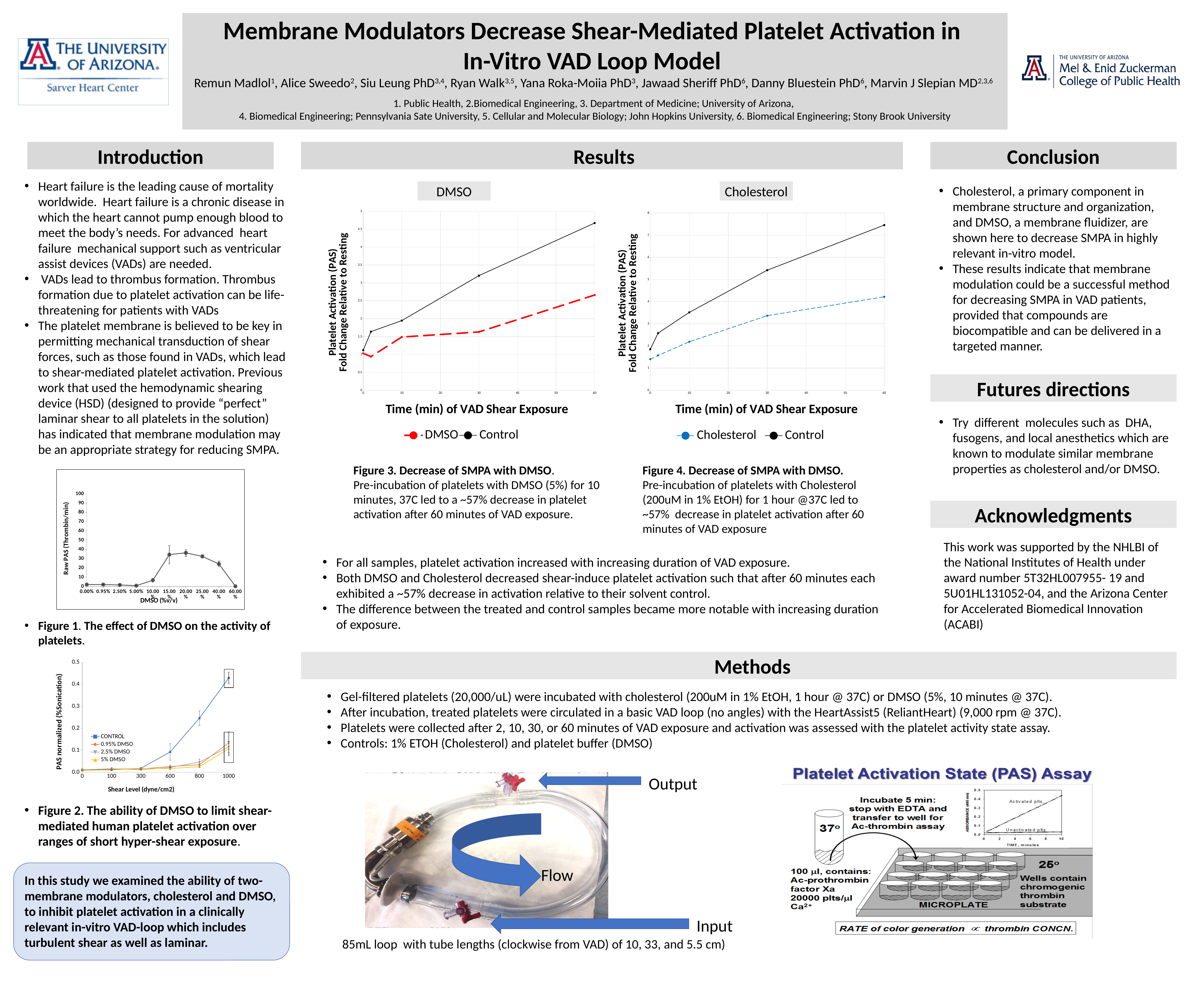
In the DMSO chart, is the DMSO value at 60 minutes greater or less than 3? less What kind of chart is the DMSO chart in the Results section? line chart In the DMSO chart, which series has the larger value at 60 minutes, DMSO or Control? Control What is the x-axis title of the Cholesterol chart? Time (min) of VAD Shear Exposure In the Figure 2 chart, which series has the highest value at a shear level of 1000? CONTROL In the Cholesterol chart, which series has the larger value at 60 minutes, Cholesterol or Control? Control How many DMSO concentration categories are shown on the x axis of the Figure 1 chart? 10 How many series does the legend of the DMSO chart list? 2 How many series does the legend of the Figure 2 chart list? 4 In the DMSO chart, does platelet activation rise or fall as time of VAD shear exposure increases? rise In the DMSO chart, is the Control value at 60 minutes greater or less than 4? greater In the Cholesterol chart, is the Cholesterol value at 60 minutes greater or less than 5? less